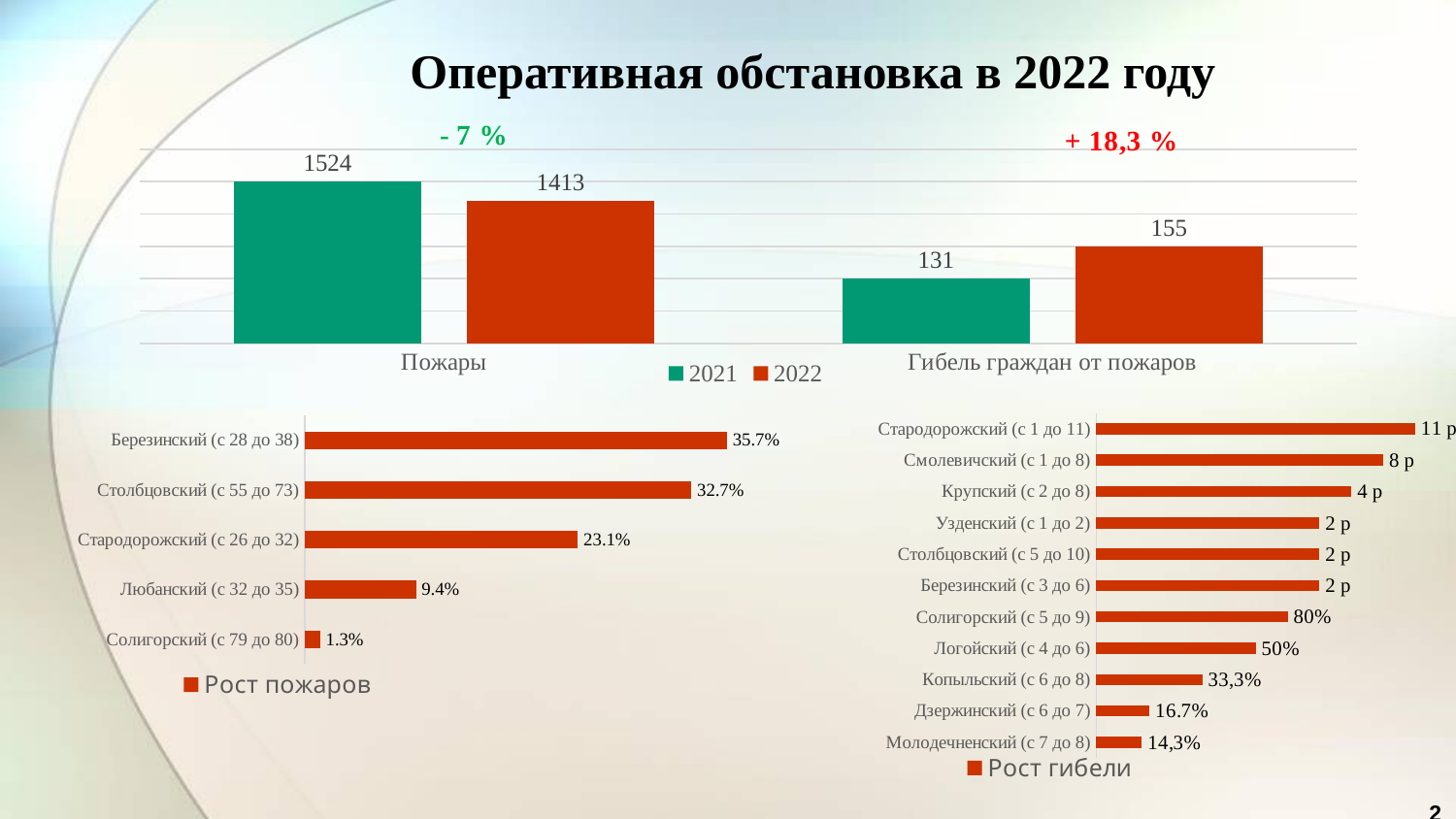
In the bottom-right chart (Рост гибели), what is the value for Солигорский (с 5 до 9)? 80% In the top chart, what is the value for Пожары in 2021? 1524 What kind of chart is the top chart? bar chart How many series does the legend of the top chart list? 2 In the bottom-right chart (Рост гибели), which category has the highest value? Стародорожский (с 1 до 11) In the top chart, which is larger for Гибель граждан от пожаров: 2021 or 2022? 2022 In the bottom-left chart (Рост пожаров), which category has the lowest value? Солигорский (с 79 до 80) In the bottom-left chart (Рост пожаров), which category has the highest value? Березинский (с 28 до 38) In the top chart, what is the value for Гибель граждан от пожаров in 2022? 155 In the top chart, what is the difference between the 2021 and 2022 values for Пожары? 111 How many categories are shown in the bottom-right chart (Рост гибели)? 11 In the bottom-left chart (Рост пожаров), what is the value for Столбцовский (с 55 до 73)? 32.7%